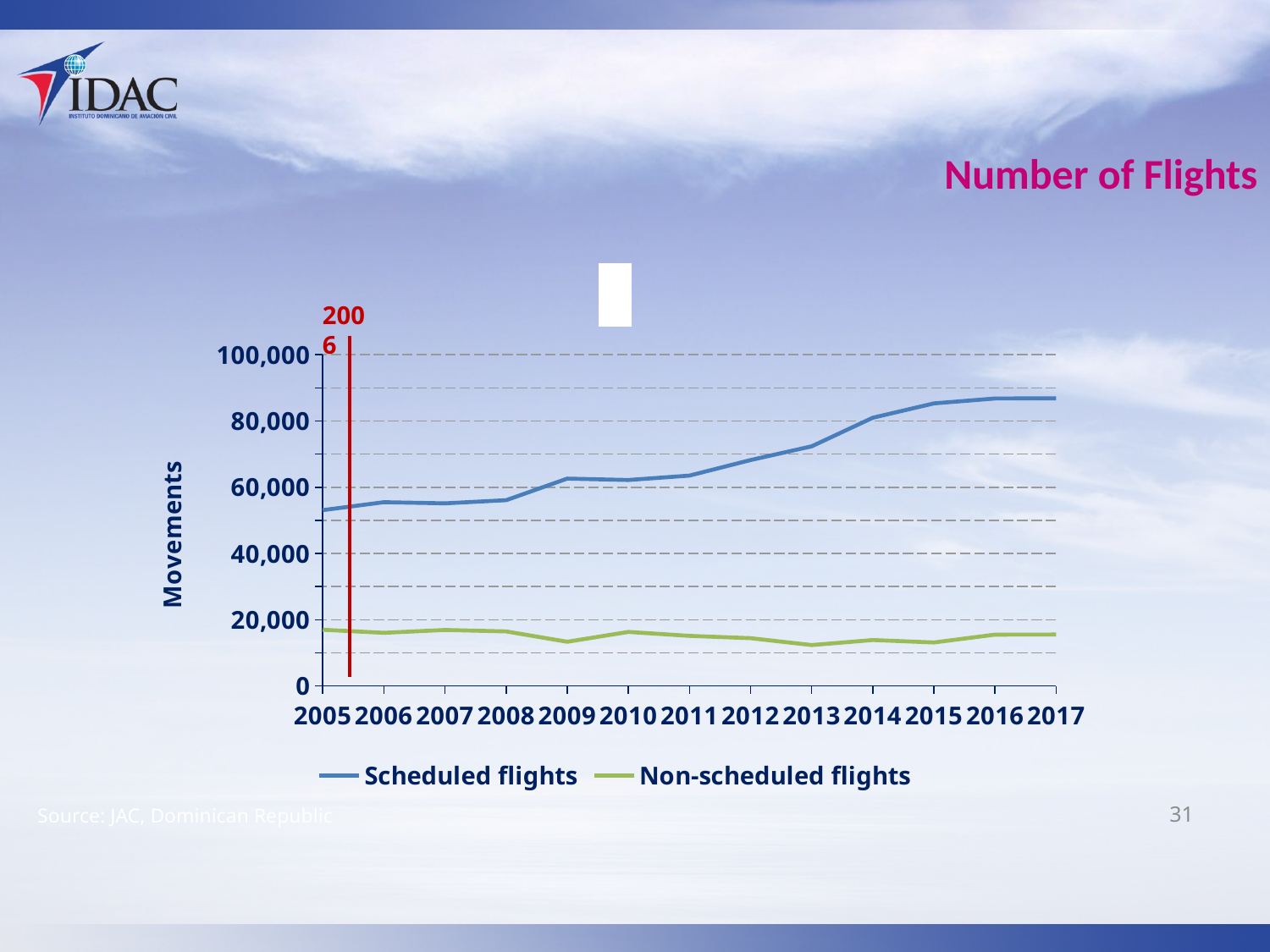
How many years are shown on the x axis? 13 In which year is the value for Scheduled flights lowest? 2005 How many series does the legend list? 2 Is the value for Scheduled flights in 2017 greater or less than 80,000? greater In 2010, which series has the larger value, Scheduled flights or Non-scheduled flights? Scheduled flights What is the title of the y axis? Movements Is the value for Scheduled flights in 2005 greater or less than 60,000? less Is the value for Non-scheduled flights in 2010 greater or less than 20,000? less Which series is plotted in green? Non-scheduled flights Do Scheduled flights generally rise or fall from 2005 to 2017? Rise What kind of chart is shown on the slide? Line chart